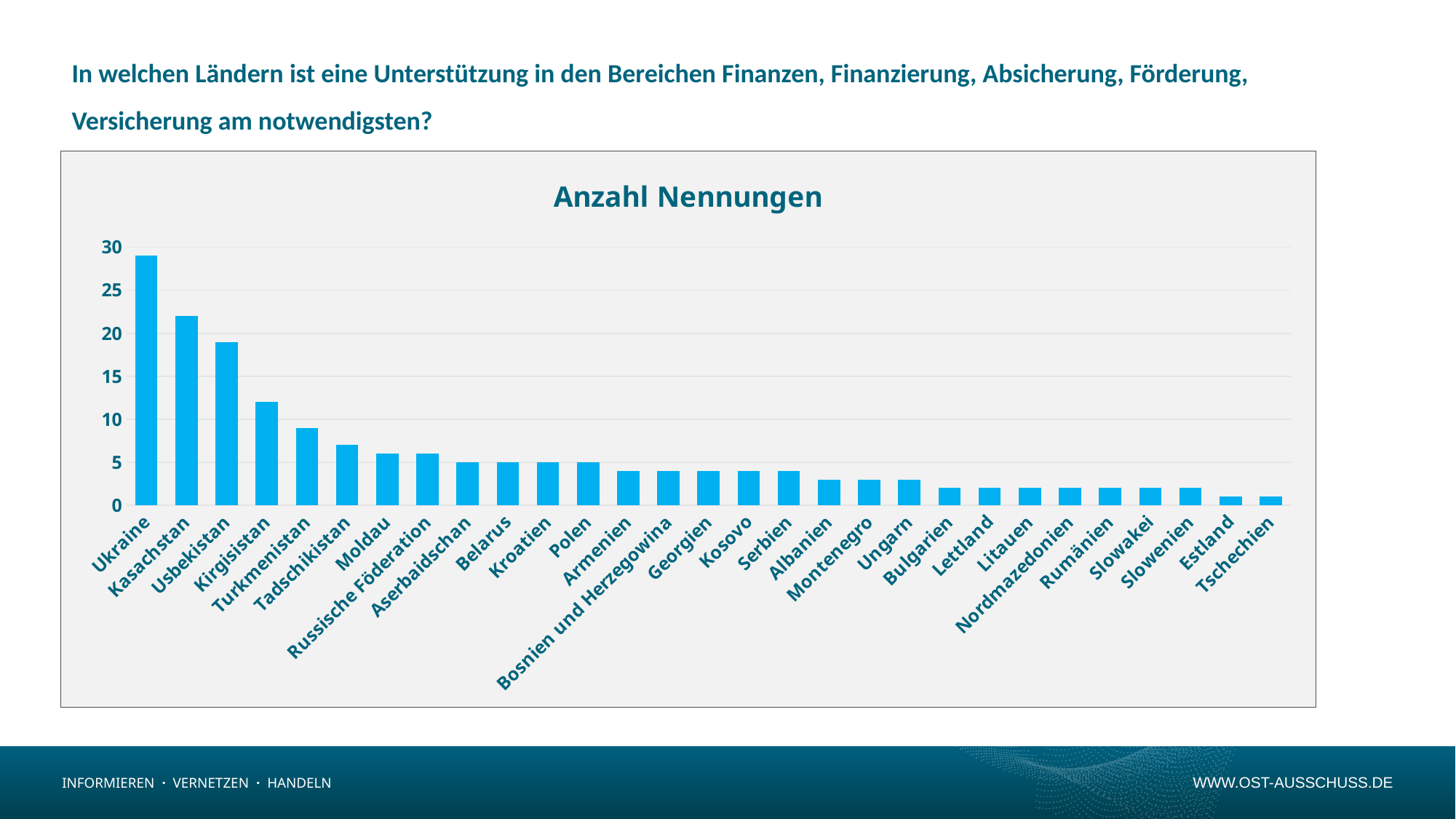
What is the title of the chart? Anzahl Nennungen Which country has the highest number of mentions? Ukraine How many countries are shown on the x axis? 29 What type of chart is shown on the slide? bar chart Is the value for Kasachstan greater or less than 20? greater Which has more mentions, Kasachstan or Usbekistan? Kasachstan Is the value for Turkmenistan greater or less than 10? less Is the value for Kirgisistan greater or less than 10? greater Do the values rise or fall from left to right along the x axis? fall